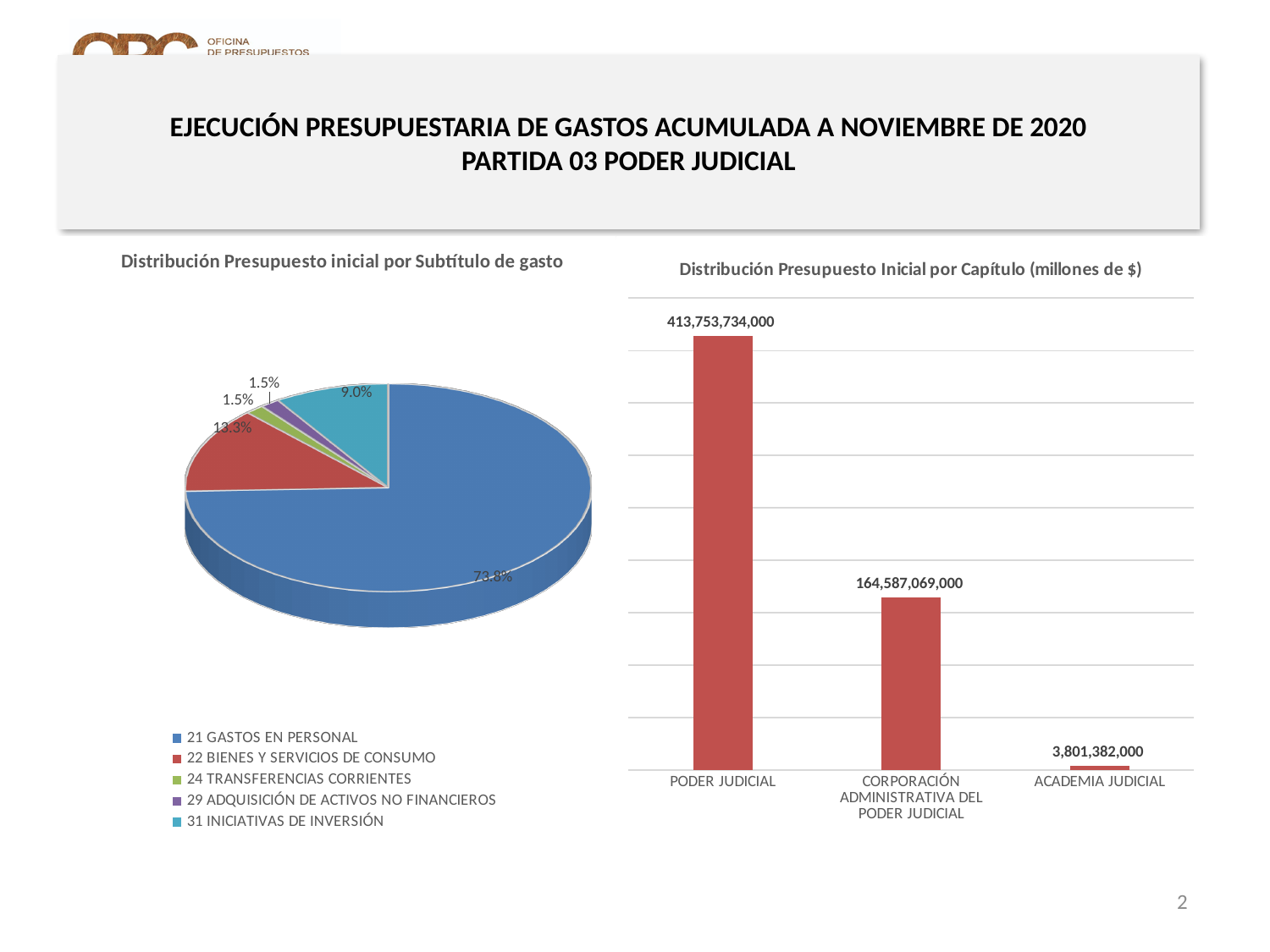
In the pie chart 'Distribución Presupuesto inicial por Subtítulo de gasto', which subtítulo has the largest share? 21 GASTOS EN PERSONAL What kind of chart is 'Distribución Presupuesto Inicial por Capítulo (millones de $)'? Bar chart In the chart 'Distribución Presupuesto Inicial por Capítulo (millones de $)', which capítulo has the lowest value? ACADEMIA JUDICIAL In the pie chart 'Distribución Presupuesto inicial por Subtítulo de gasto', what share does 21 GASTOS EN PERSONAL have? 73.8% What kind of chart is 'Distribución Presupuesto inicial por Subtítulo de gasto'? Pie chart In the chart 'Distribución Presupuesto Inicial por Capítulo (millones de $)', what is the difference between PODER JUDICIAL and CORPORACIÓN ADMINISTRATIVA DEL PODER JUDICIAL? 249,166,665,000 In the chart 'Distribución Presupuesto Inicial por Capítulo (millones de $)', what is the value for ACADEMIA JUDICIAL? 3,801,382,000 In the pie chart 'Distribución Presupuesto inicial por Subtítulo de gasto', what share does 22 BIENES Y SERVICIOS DE CONSUMO have? 13.3% In the pie chart 'Distribución Presupuesto inicial por Subtítulo de gasto', what share does 31 INICIATIVAS DE INVERSIÓN have? 9.0% How many entries does the legend of the pie chart 'Distribución Presupuesto inicial por Subtítulo de gasto' list? 5 In the chart 'Distribución Presupuesto Inicial por Capítulo (millones de $)', what is the value for PODER JUDICIAL? 413,753,734,000 In the chart 'Distribución Presupuesto Inicial por Capítulo (millones de $)', what is the value for CORPORACIÓN ADMINISTRATIVA DEL PODER JUDICIAL? 164,587,069,000